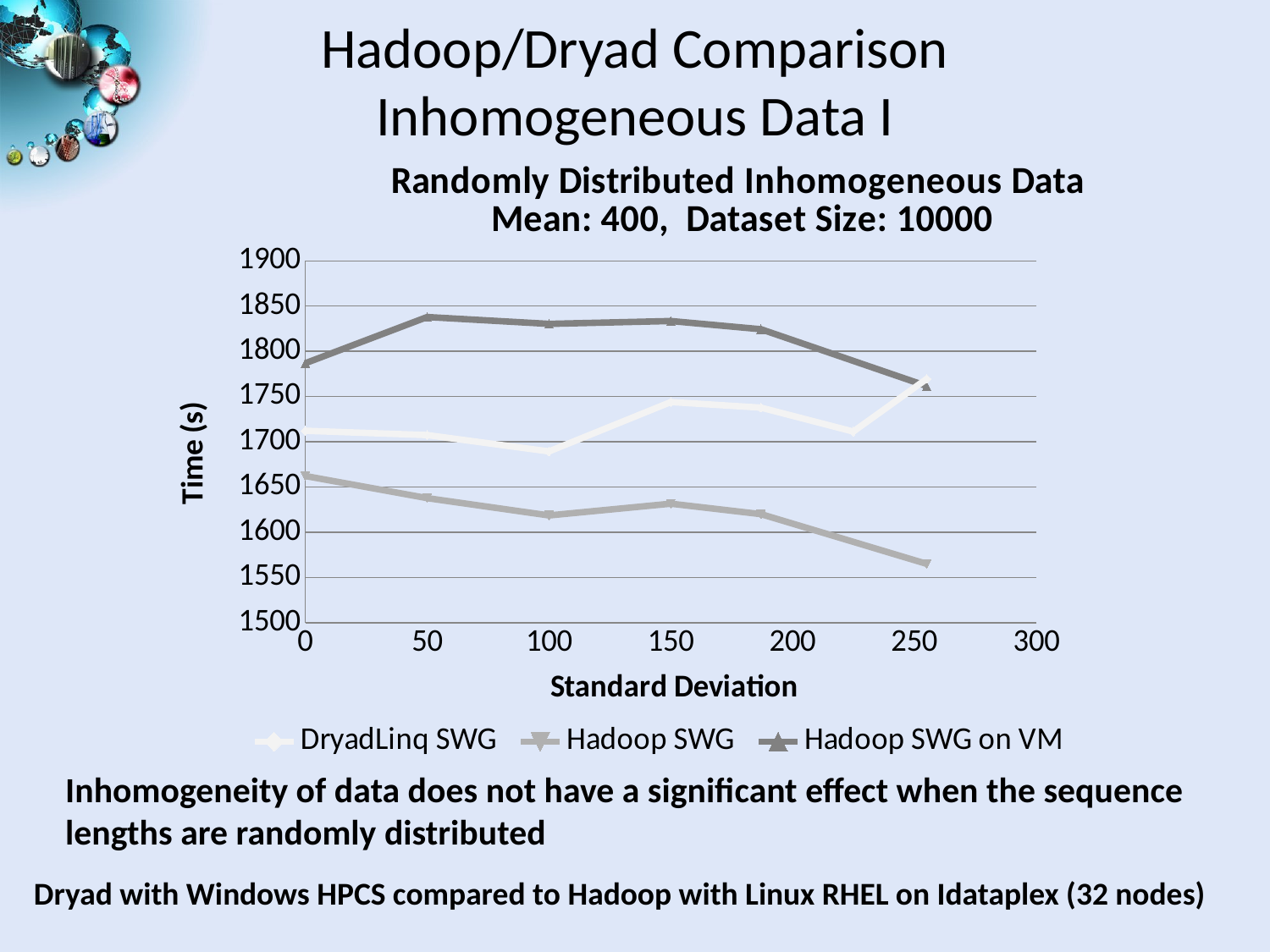
At standard deviation 50, which is larger: Hadoop SWG on VM or Hadoop SWG? Hadoop SWG on VM What is the label of the y axis? Time (s) Which series has the highest values across the chart? Hadoop SWG on VM Is the value for Hadoop SWG on VM at standard deviation 0 greater or less than 1800? less How many series does the legend list? 3 Which series has the lowest values across the chart? Hadoop SWG What are the three series named in the legend? DryadLinq SWG, Hadoop SWG, Hadoop SWG on VM Is the value for Hadoop SWG at standard deviation 100 greater or less than 1650? less Is the value for Hadoop SWG on VM at standard deviation 50 greater or less than 1800? greater Does the Hadoop SWG series generally rise or fall as standard deviation increases? fall What kind of chart is shown on the slide? line chart